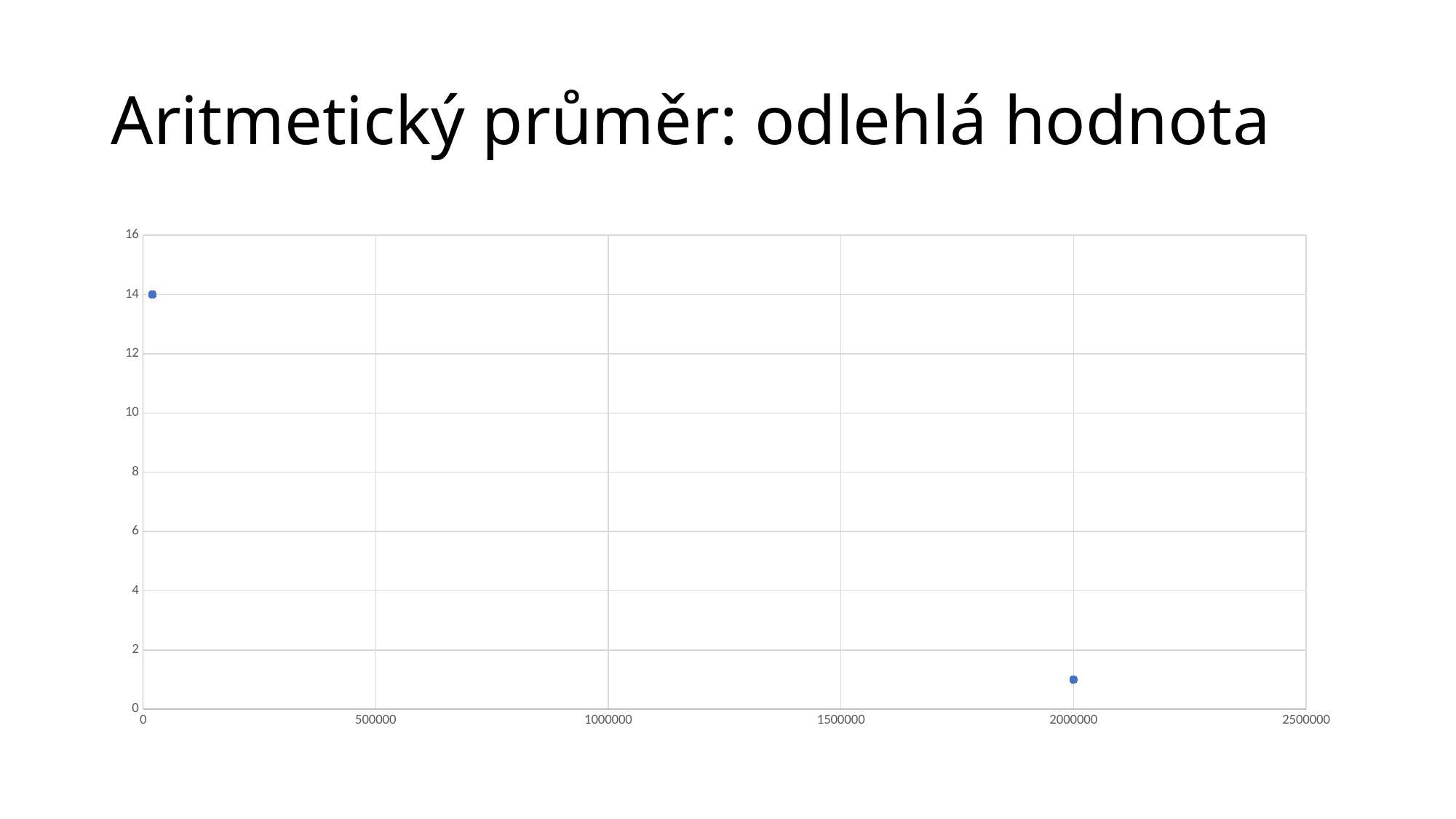
Is the x value of the leftmost point greater or less than 500000? less Which point has the higher y value: the one near x = 0 or the one at x = 2000000? the one near x = 0 Which point has the lowest y value on the chart? the point at x = 2000000 What kind of chart is shown on the slide? scatter chart How many data points are plotted on the chart? 2 What is the y value of the data point plotted near x = 0? 14 Is the y value of the point at x = 2000000 greater or less than 2? less What is the x value of the data point plotted at the far right of the chart? 2000000 Is the y value of the point near x = 0 greater or less than 12? greater What is the highest value shown on the y axis? 16 What is the title of the slide above the chart? Aritmetický průměr: odlehlá hodnota Do the y values rise or fall as x increases along the x axis? fall